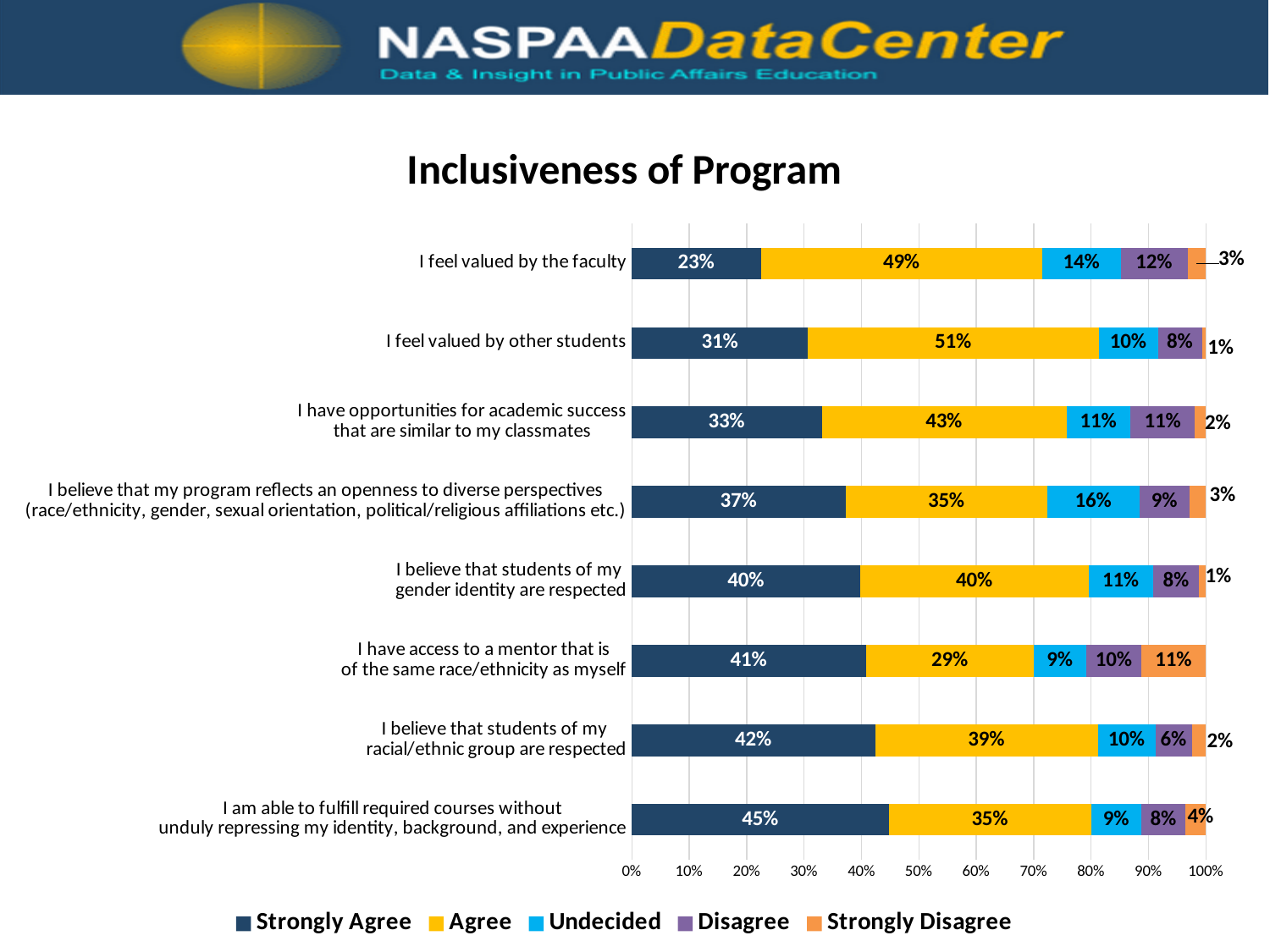
What percentage of respondents strongly agree with "I feel valued by the faculty"? 23% How many statements are shown in the chart? 8 What is the difference between the Strongly Agree values for "I feel valued by other students" and "I feel valued by the faculty"? 8% What is the Agree value for "I feel valued by other students"? 51% How many series does the legend list? 5 Which statement has the lowest Strongly Agree percentage? I feel valued by the faculty What kind of chart is shown on the slide? Stacked bar chart Which statement has the highest Strongly Agree percentage? I am able to fulfill required courses without unduly repressing my identity, background, and experience What is the Strongly Disagree value for "I have access to a mentor that is of the same race/ethnicity as myself"? 11% What is the combined Strongly Agree and Agree percentage for "I believe that students of my gender identity are respected"? 80% What is the Undecided value for "I believe that my program reflects an openness to diverse perspectives"? 16% Which is larger: the Agree value for "I feel valued by the faculty" or the Agree value for "I have access to a mentor that is of the same race/ethnicity as myself"? I feel valued by the faculty